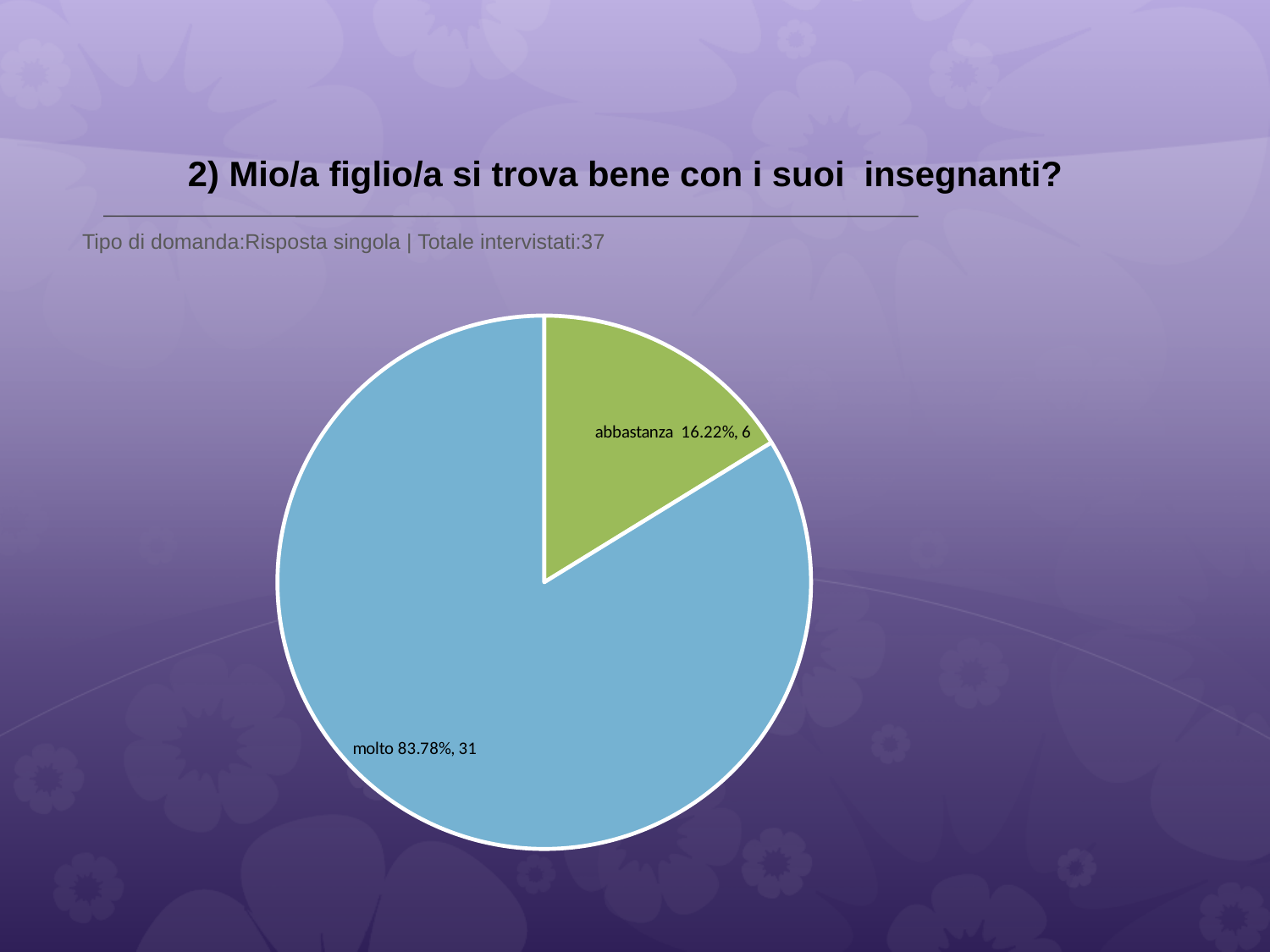
How many respondents answered 'abbastanza'? 6 Which response has the largest slice of the pie? molto What kind of chart is shown on the slide? pie chart How many slices does the pie chart have? 2 Which slice is larger, 'molto' or 'abbastanza'? molto What colour is the 'abbastanza' slice? green What is the total number of respondents shown across both slices? 37 What percentage share does the 'abbastanza' slice have? 16.22% How many respondents answered 'molto'? 31 What is the difference in number of respondents between 'molto' and 'abbastanza'? 25 What percentage share does the 'molto' slice have? 83.78% Which response has the smallest slice of the pie? abbastanza